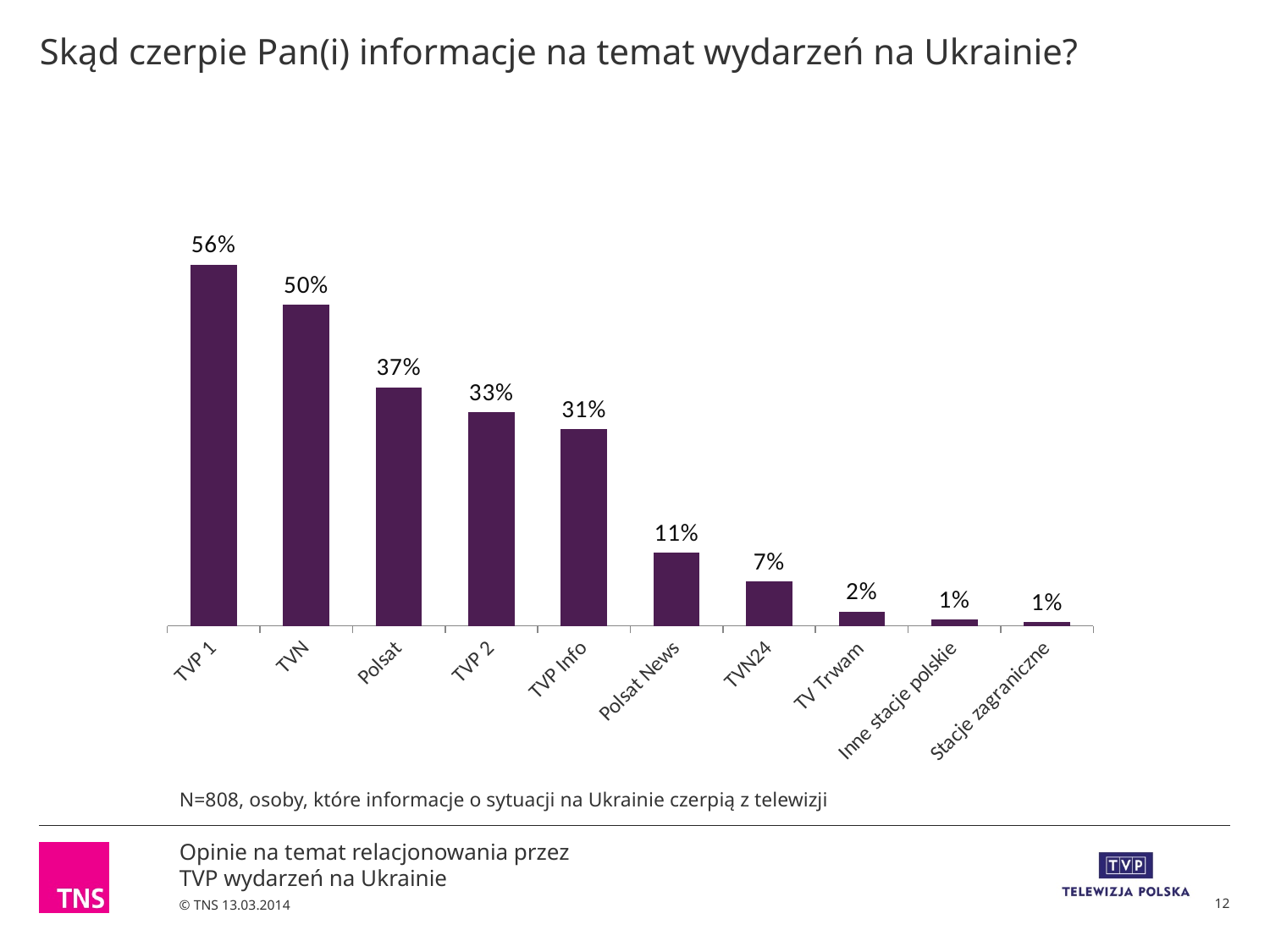
What is the value for Polsat? 37% What is the value for TVP 1? 56% How many categories are shown on the x axis? 10 What kind of chart is shown on the slide? bar chart What is the difference between the values for TVP 2 and TVP Info? 2% What is the value for TV Trwam? 2% Do the values rise or fall from left to right along the x axis? fall Which category has the highest value? TVP 1 What is the difference between the values for TVP 1 and TVN? 6% What is the value for TVN24? 7% Which is larger, the value for Polsat or the value for TVP 2? Polsat Which is larger, the value for Polsat News or the value for TVN24? Polsat News